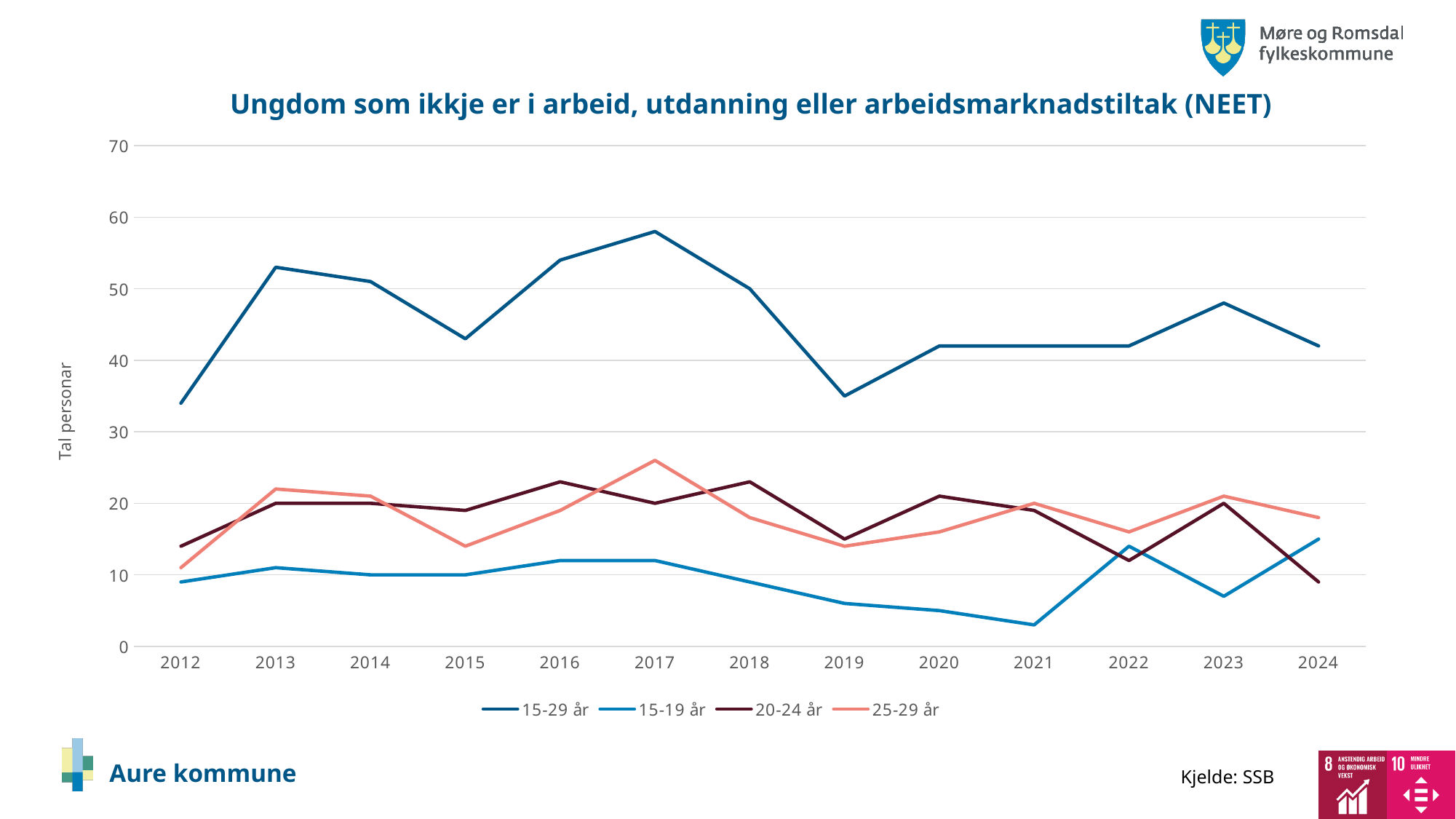
In which year does the 15-29 år series reach its highest value? 2017 What is the label on the y axis? Tal personar Is the value for 15-29 år in 2017 greater or less than 50? greater Does the 15-19 år series rise or fall from 2017 to 2021? fall How many years are shown along the x axis? 13 In which year does the 15-19 år series reach its lowest value? 2021 In which year does the 25-29 år series reach its highest value? 2017 What kind of chart is shown on the slide? line chart Is the value for 15-29 år in 2019 greater or less than 40? less Is the value for 15-19 år in 2021 greater or less than 10? less Which is larger in 2024: the value for 15-19 år or the value for 20-24 år? 15-19 år How many series does the legend list? 4